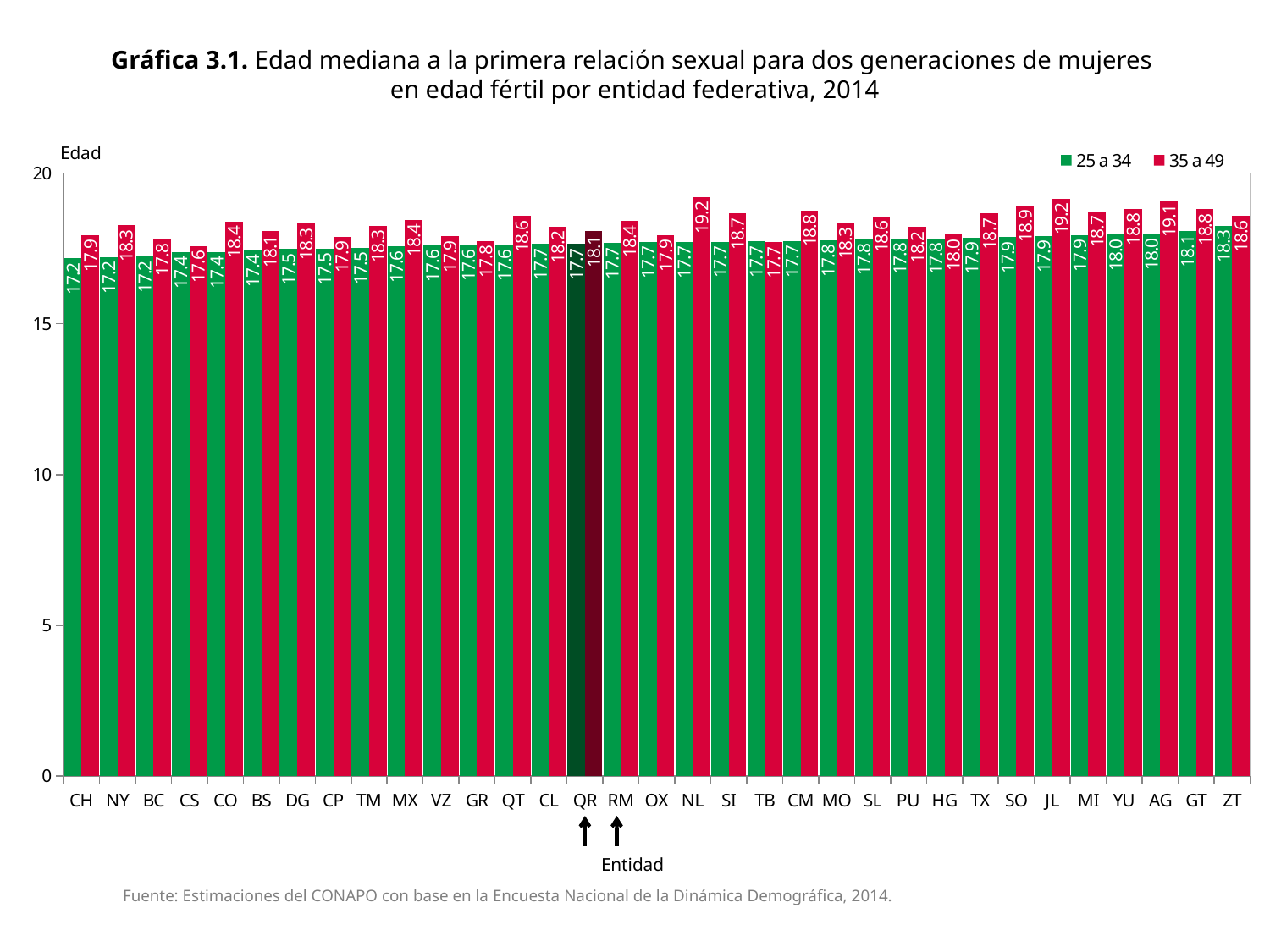
Which is larger for TB: the 25 a 34 value or the 35 a 49 value? They are equal (17.7) What is the value for QR in the 35 a 49 series? 18.1 What is the value for NL in the 35 a 49 series? 19.2 How many series does the legend list? 2 What is the difference between the 35 a 49 and 25 a 34 values for AG? 1.1 What kind of chart is this? Bar chart What is the label of the y axis? Edad How many entities are shown on the x axis? 33 Which entity has the highest value in the 25 a 34 series? ZT Which entity has the lowest value in the 35 a 49 series? CS Is the 35 a 49 value for JL greater or less than 15? greater What is the value for ZT in the 25 a 34 series? 18.3